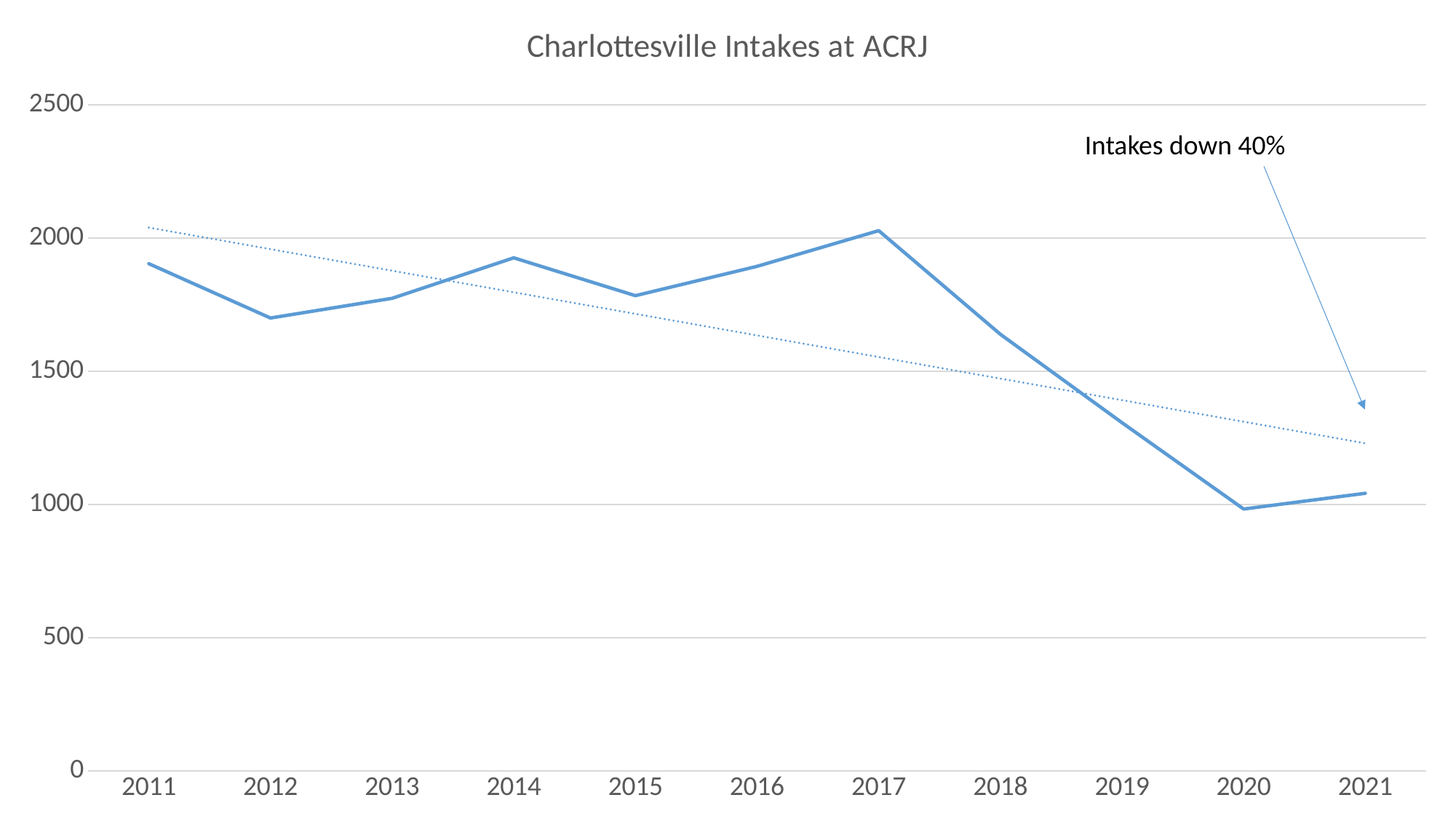
Is the value for 2011 greater or less than 1500? greater Which year has the lowest number of intakes? 2020 What does the text annotation on the chart say? Intakes down 40% Which year has the highest number of intakes? 2017 How many years are plotted along the x axis? 11 Which year has more intakes, 2014 or 2012? 2014 Is the value for 2017 greater or less than 2000? greater Is the value for 2019 greater or less than 1500? less What is the title of the chart? Charlottesville Intakes at ACRJ Overall, do intakes rise or fall from 2011 to 2021? fall What kind of chart is shown on the slide? line chart